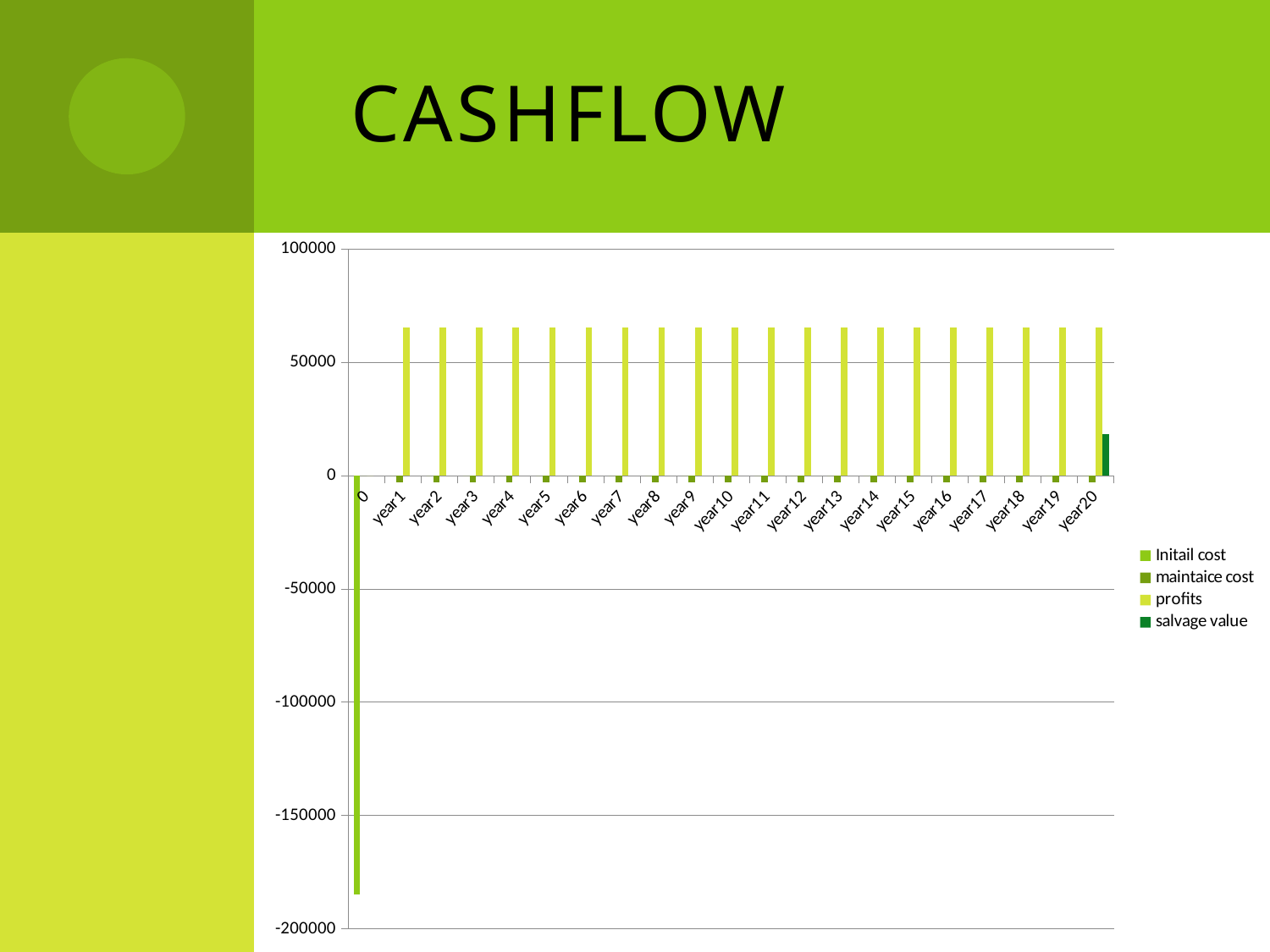
Which series in the CASHFLOW chart has the lowest (most negative) value? Initail cost In which category does the salvage value series appear in the CASHFLOW chart? year20 In the CASHFLOW chart, do the profits bars rise, fall, or stay roughly constant from year1 to year20? stay roughly constant How many categories are shown along the x axis of the CASHFLOW chart? 21 In the CASHFLOW chart, is the profits value for year10 greater or less than 100000? less What is the title of the chart on the slide? CASHFLOW In the CASHFLOW chart, is the salvage value for year20 greater or less than 50000? less How many series does the legend of the CASHFLOW chart list? 4 What kind of chart is shown on the CASHFLOW slide? bar chart In the CASHFLOW chart, is the profits value for year1 greater or less than 50000? greater In the CASHFLOW chart, which is larger for year20: profits or salvage value? profits